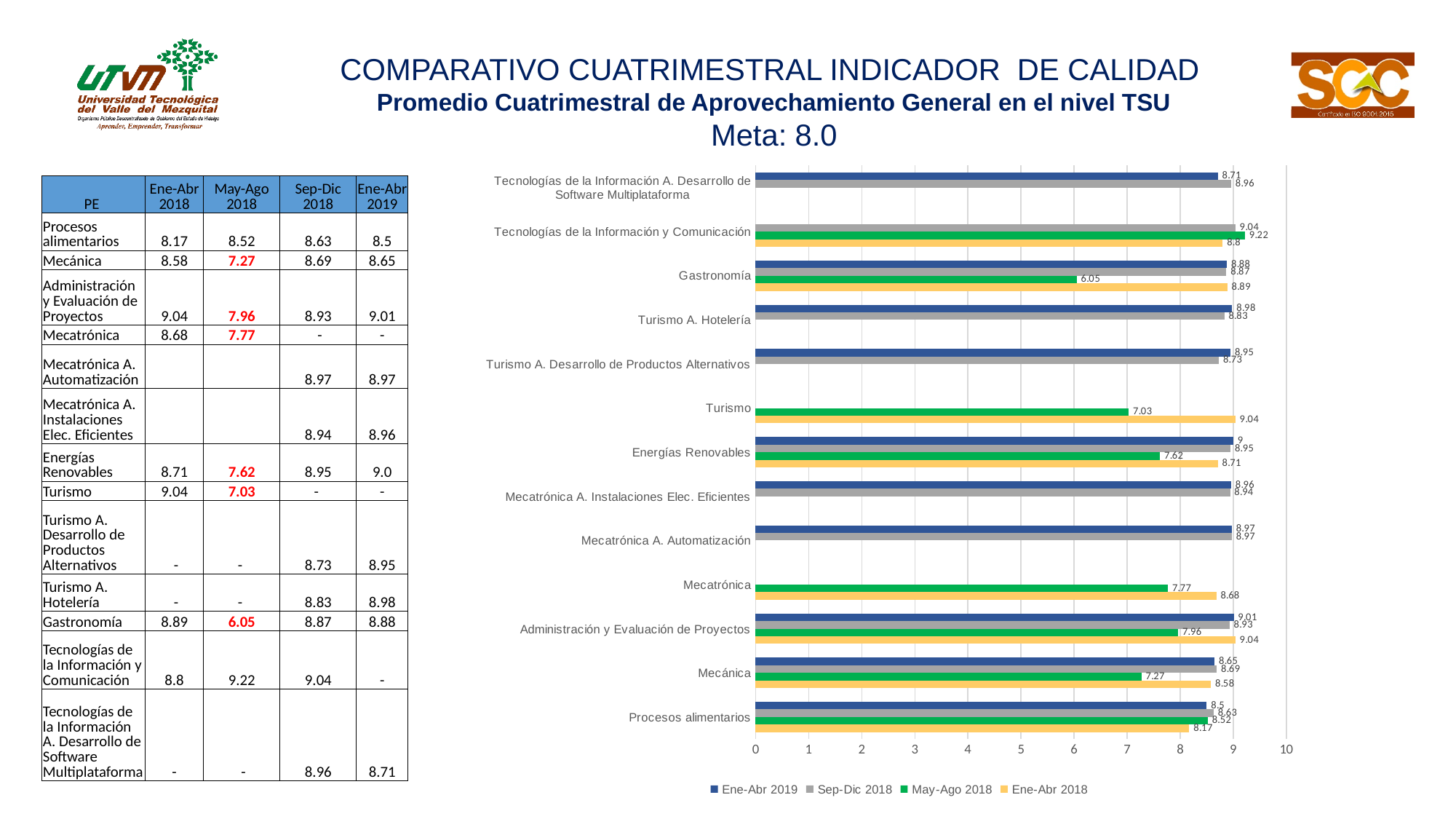
How many series does the chart legend list? 4 What is the May-Ago 2018 value for Mecatrónica on the chart? 7.77 Is the May-Ago 2018 value for Turismo greater or less than 8? less Which category has the highest May-Ago 2018 value on the chart? Tecnologías de la Información y Comunicación What kind of chart is shown on the slide? bar chart What is the Ene-Abr 2018 value for Turismo on the chart? 9.04 Which category has the lowest May-Ago 2018 value on the chart? Gastronomía What colour represents the May-Ago 2018 series in the chart legend? green What is the May-Ago 2018 value for Gastronomía on the chart? 6.05 On the chart, which is larger for Energías Renovables: the Ene-Abr 2019 value or the Ene-Abr 2018 value? Ene-Abr 2019 On the chart, what is the difference between the Sep-Dic 2018 and May-Ago 2018 values for Mecánica? 1.42 How many program categories are plotted on the chart? 13